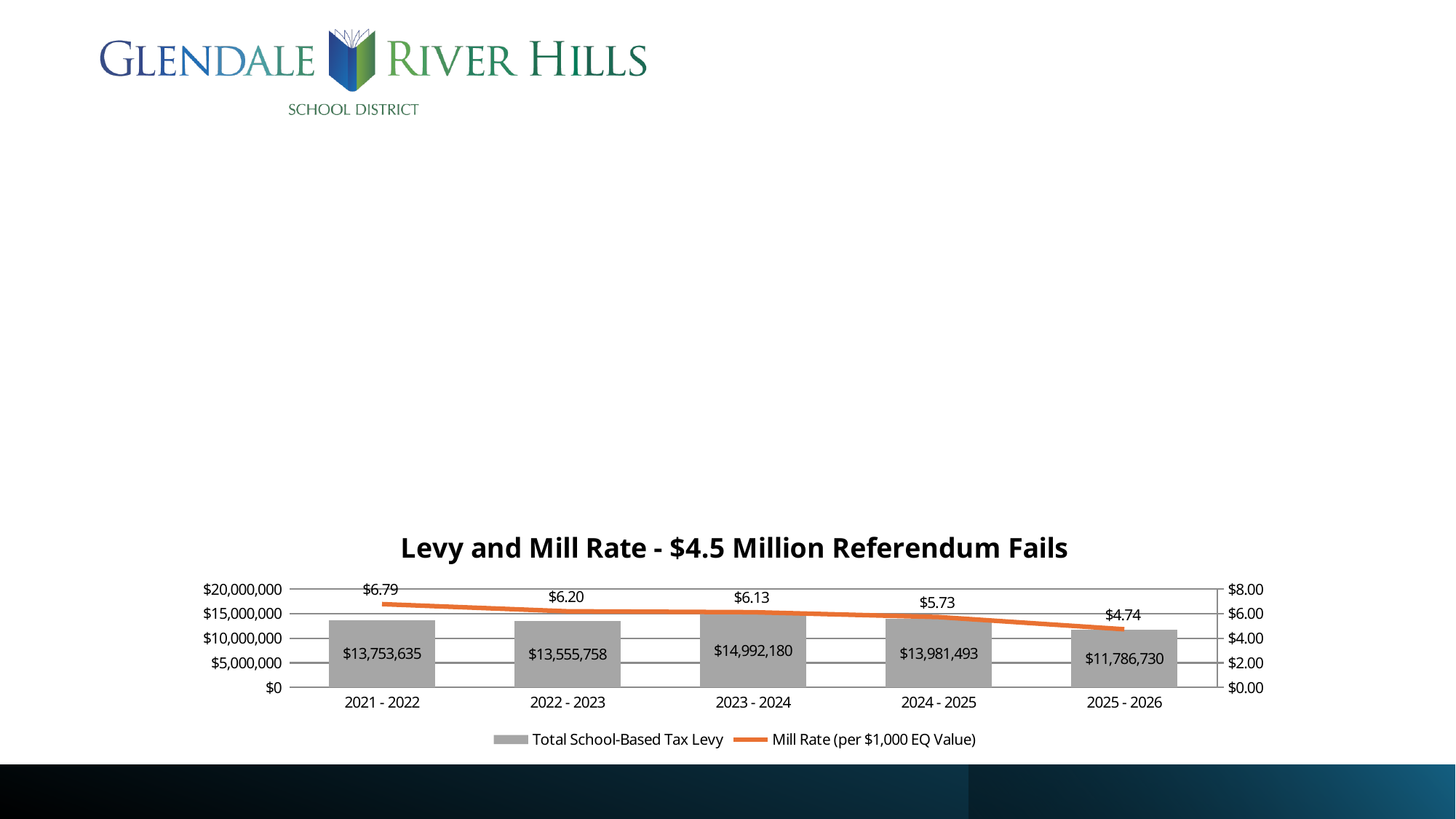
Which is larger, the Total School-Based Tax Levy for 2024 - 2025 or for 2022 - 2023? 2024 - 2025 What is the Mill Rate (per $1,000 EQ Value) for 2025 - 2026? $4.74 Which year has the highest Total School-Based Tax Levy? 2023 - 2024 How many series does the legend list? 2 By how much does the Mill Rate fall from 2021 - 2022 to 2025 - 2026? $2.05 How many school years are shown on the x axis? 5 What is the Total School-Based Tax Levy for 2021 - 2022? $13,753,635 What is the Total School-Based Tax Levy for 2023 - 2024? $14,992,180 Which year has the lowest Mill Rate (per $1,000 EQ Value)? 2025 - 2026 What kind of chart is this? Combined bar and line chart Does the Mill Rate (per $1,000 EQ Value) rise or fall across the years shown? Fall What is the difference between the highest and lowest Total School-Based Tax Levy values? $3,205,450